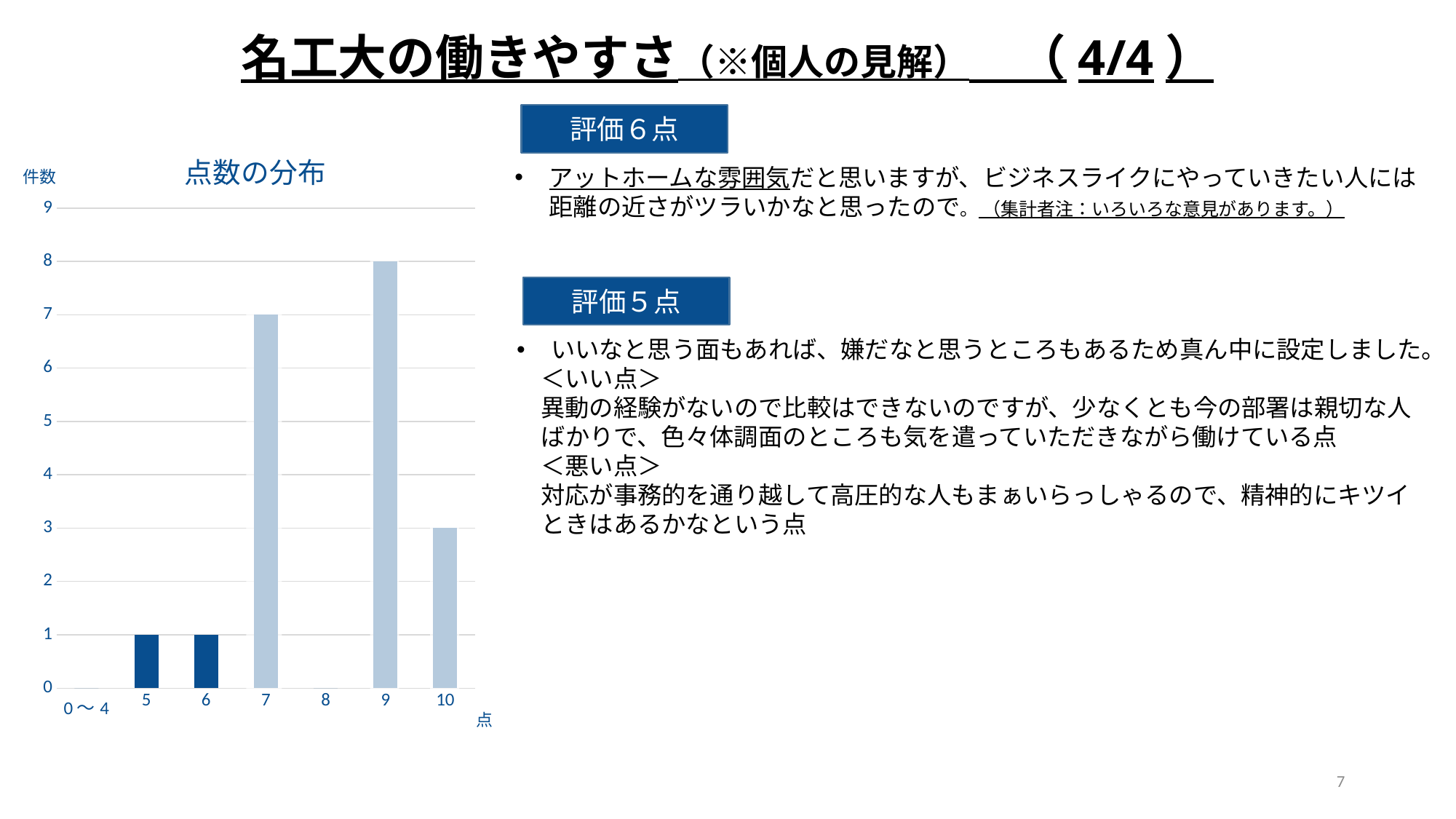
What type of chart is shown on the slide? bar chart What is the value (件数) for score 7? 7 What is the chart title? 点数の分布 Which score categories are drawn in a darker blue than the others? 5 and 6 Which has a larger count, score 7 or score 10? 7 What is the value (件数) for score 9? 8 How many score categories are shown on the x axis of the chart? 7 Which score category has the highest count? 9 Is the value for score 9 greater or less than 5? greater What is the value (件数) for score 5? 1 What is the difference between the counts for score 9 and score 7? 1 What is the value (件数) for score 10? 3